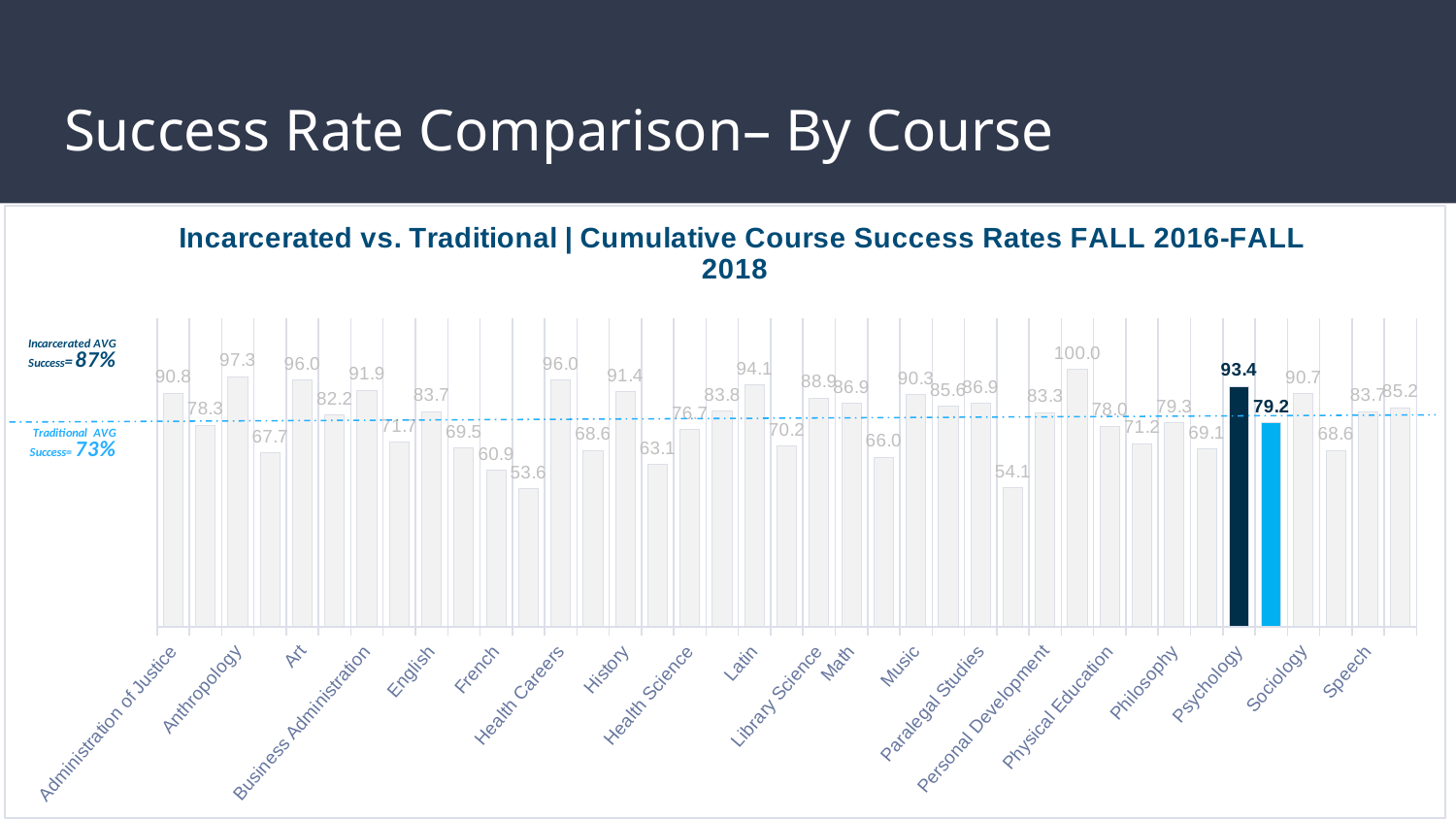
What is the difference between the two highlighted Psychology bars (93.4 and 79.2)? 14.2 What is the value of the light blue highlighted bar for Psychology? 79.2 What type of chart is shown on the slide? bar chart What is the Traditional average success rate shown on the left of the chart? 73% Which average success rate is higher, Incarcerated or Traditional? Incarcerated What is the value of the dark highlighted bar for Psychology? 93.4 How many courses are listed along the x axis of the chart? 20 Which of the two Psychology bars is larger, the dark one or the light blue one? the dark one (93.4) What is the title of the chart? Incarcerated vs. Traditional | Cumulative Course Success Rates FALL 2016-FALL 2018 What is the highest value labelled on any bar in the chart? 100.0 What is the Incarcerated average success rate shown on the left of the chart? 87% What is the lowest value labelled on any bar in the chart? 53.6